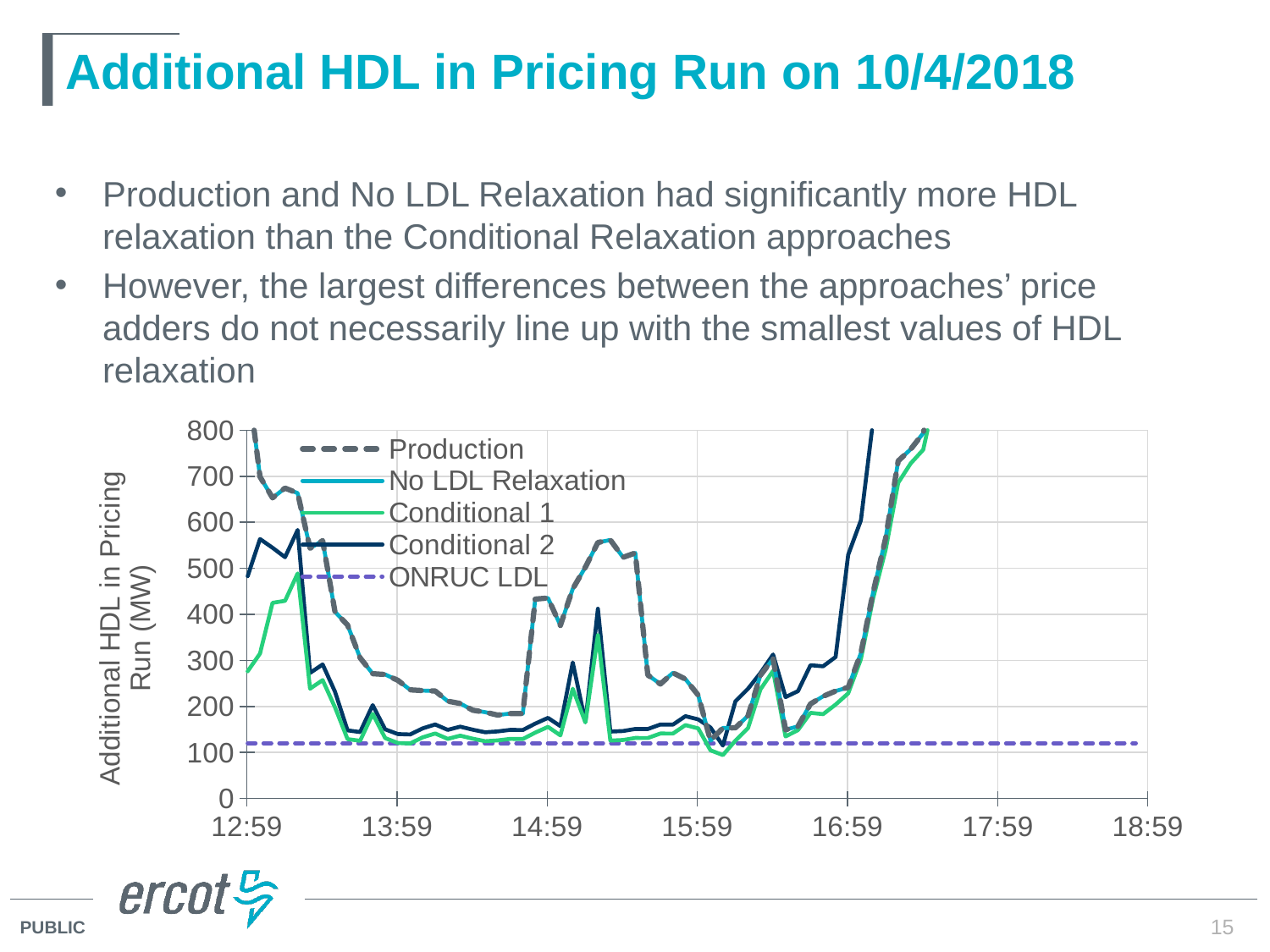
How many time labels are shown on the horizontal axis? 7 Is the Conditional 1 value at 12:59 greater or less than 400? less Does the Production line rise or fall between 12:59 and 13:59? fall Is the Conditional 2 value at 12:59 greater or less than 400? greater Is the value of the ONRUC LDL line greater or less than 200? less At 12:59, which is larger: the Production value or the Conditional 1 value? Production Which series in the legend is drawn as a flat horizontal dashed line across the whole chart? ONRUC LDL What is the label of the vertical axis of the chart? Additional HDL in Pricing Run (MW) How many series does the chart legend list? 5 What kind of chart is shown on the slide? line chart